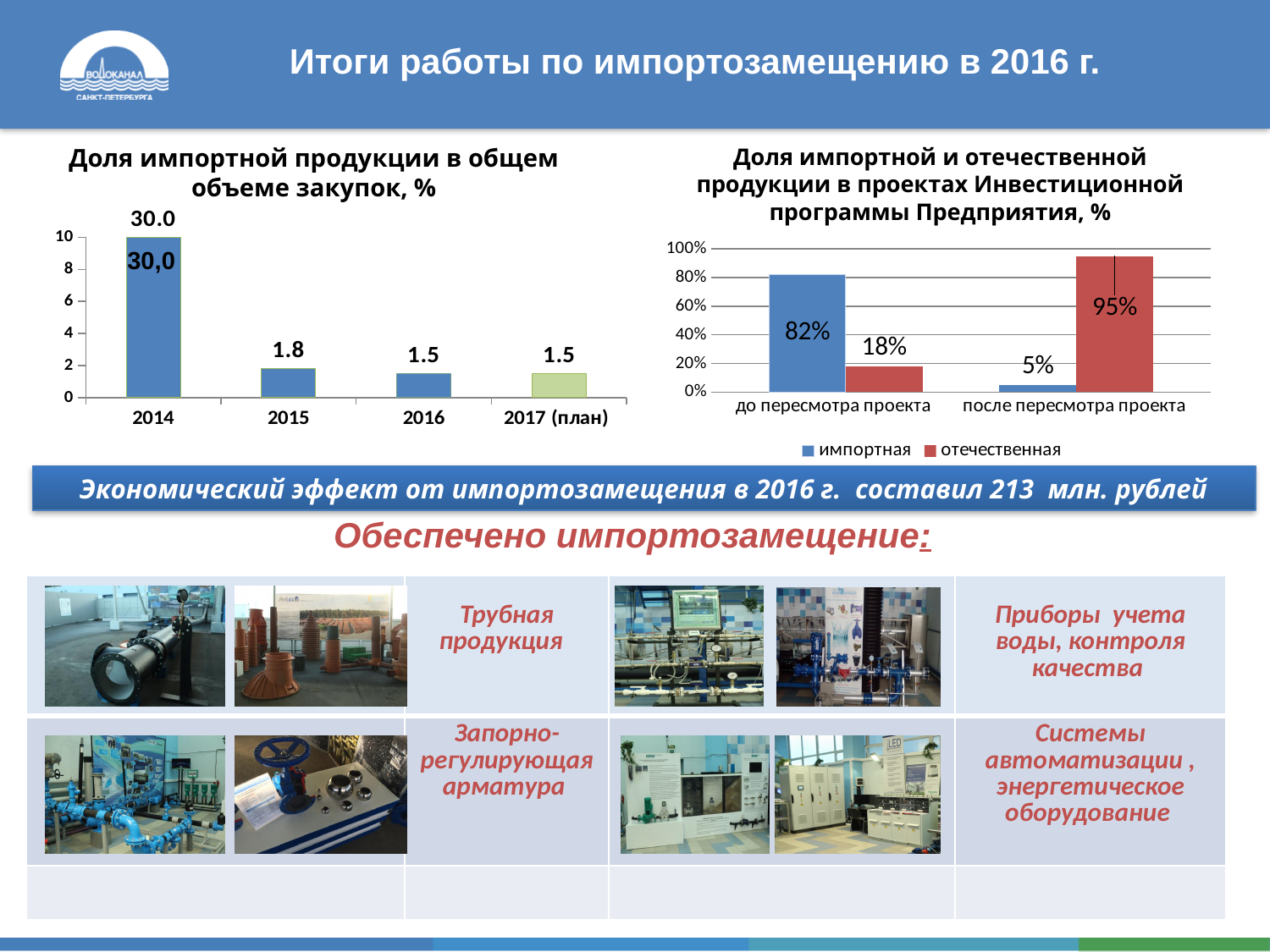
In the left chart 'Доля импортной продукции в общем объеме закупок, %', what is the value for 2015? 1.8 In the left chart 'Доля импортной продукции в общем объеме закупок, %', what is the difference between the 2014 and 2015 values? 28.2 In the right chart 'Доля импортной и отечественной продукции в проектах Инвестиционной программы Предприятия, %', what is the value for импортная before the project revision (до пересмотра проекта)? 82% In the left chart 'Доля импортной продукции в общем объеме закупок, %', which year has the highest value? 2014 In the left chart 'Доля импортной продукции в общем объеме закупок, %', how many categories are shown on the x axis? 4 What type of chart is the right chart 'Доля импортной и отечественной продукции в проектах Инвестиционной программы Предприятия, %'? bar chart In the right chart 'Доля импортной и отечественной продукции в проектах Инвестиционной программы Предприятия, %', how many series does the legend list? 2 In the left chart 'Доля импортной продукции в общем объеме закупок, %', what is the value for 2017 (план)? 1.5 In the left chart 'Доля импортной продукции в общем объеме закупок, %', what is the value for 2014? 30.0 In the right chart 'Доля импортной и отечественной продукции в проектах Инвестиционной программы Предприятия, %', which is larger before the project revision: импортная or отечественная? импортная In the right chart 'Доля импортной и отечественной продукции в проектах Инвестиционной программы Предприятия, %', what is the value for отечественная after the project revision (после пересмотра проекта)? 95% In the left chart 'Доля импортной продукции в общем объеме закупок, %', do the values rise or fall from 2014 to 2016? fall